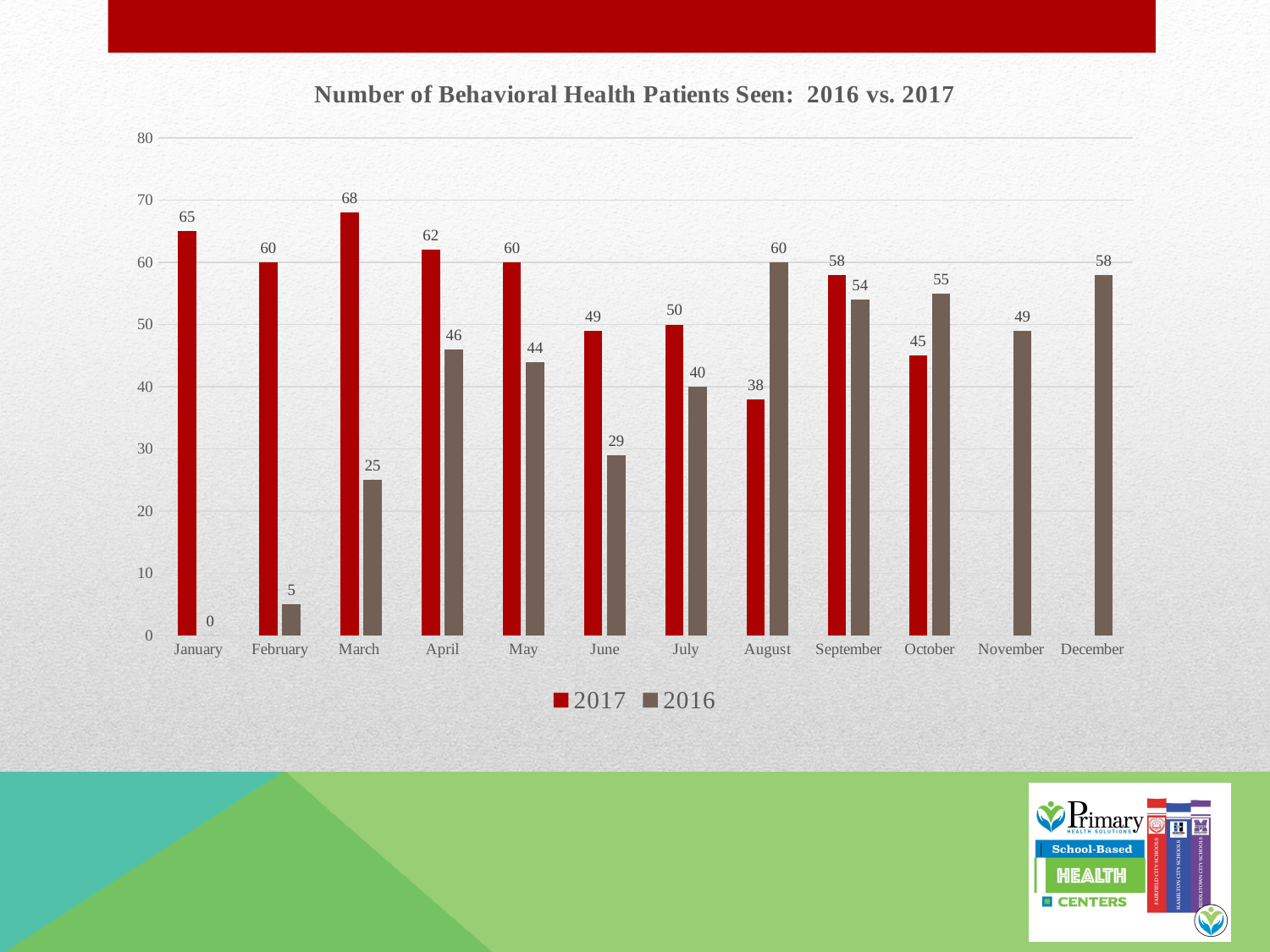
What is the 2017 value for March? 68 What is the title of the chart? Number of Behavioral Health Patients Seen: 2016 vs. 2017 What kind of chart is shown? Bar chart Which month has the lowest 2016 value? January How many series does the legend list? 2 What is the difference between the 2017 and 2016 values for March? 43 How many months are shown on the x axis? 12 What is the 2016 value for February? 5 Which month has the highest 2017 value? March What is the 2016 value for August? 60 Which is larger for August, the 2017 value or the 2016 value? 2016 Which colour represents the 2017 series? Red